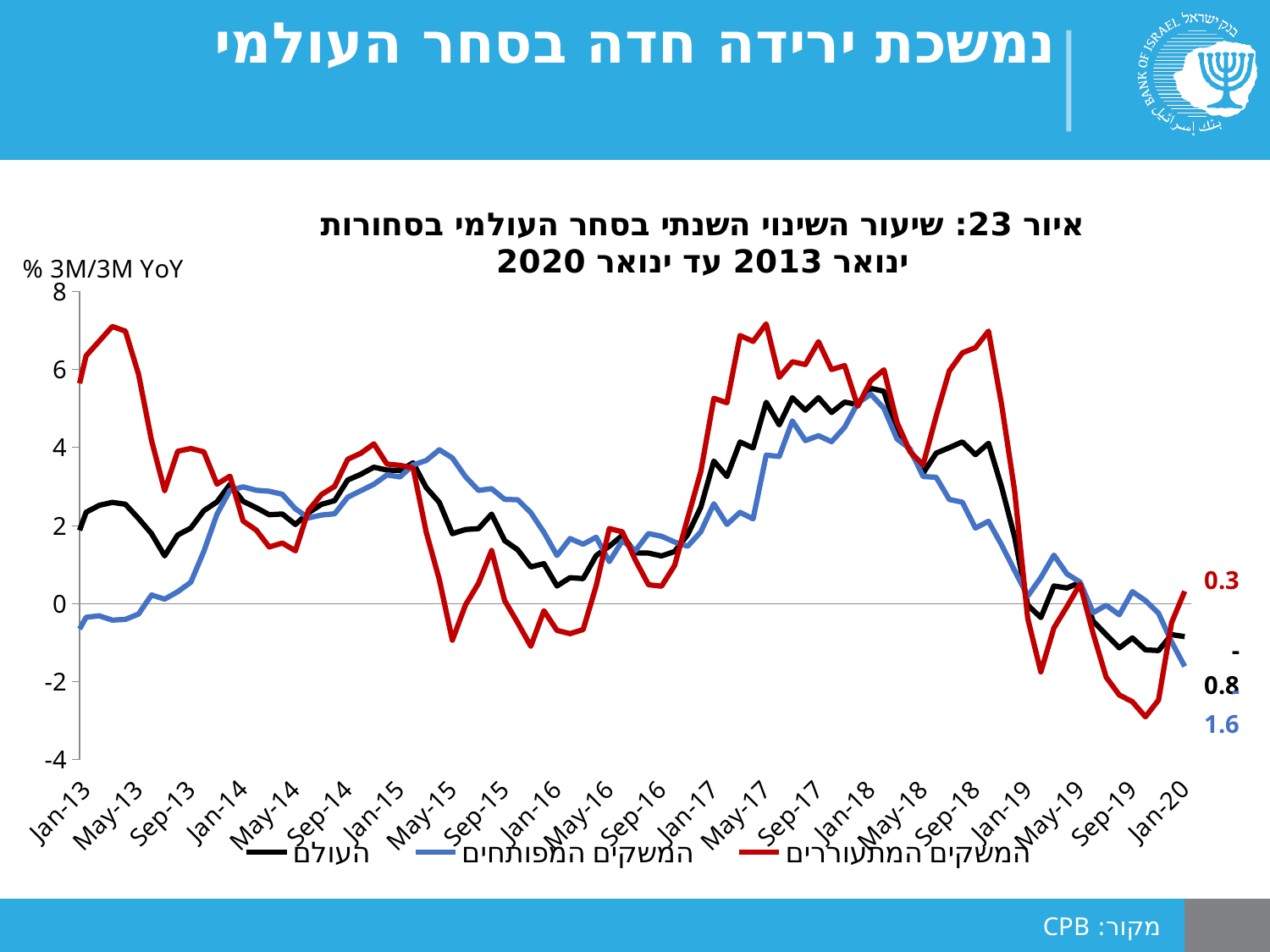
Does the העולם series rise or fall between Sep-18 and Sep-19? fall What colour is the line for המשקים המפותחים? blue What is the label on the vertical axis? % 3M/3M YoY Is the value for המשקים המפותחים at Jan-13 greater or less than 0? less Which series has the highest value at Jan-20? המשקים המתעוררים At Jan-13, which series is higher: המשקים המתעוררים or העולם? המשקים המתעוררים Is the value for העולם at Jan-18 greater or less than 4? greater How many series does the legend list? 3 What is the value of המשקים המתעוררים at Jan-20? 0.3 Which series has the lowest value at Jan-20? המשקים המפותחים What kind of chart is shown on the slide? line chart